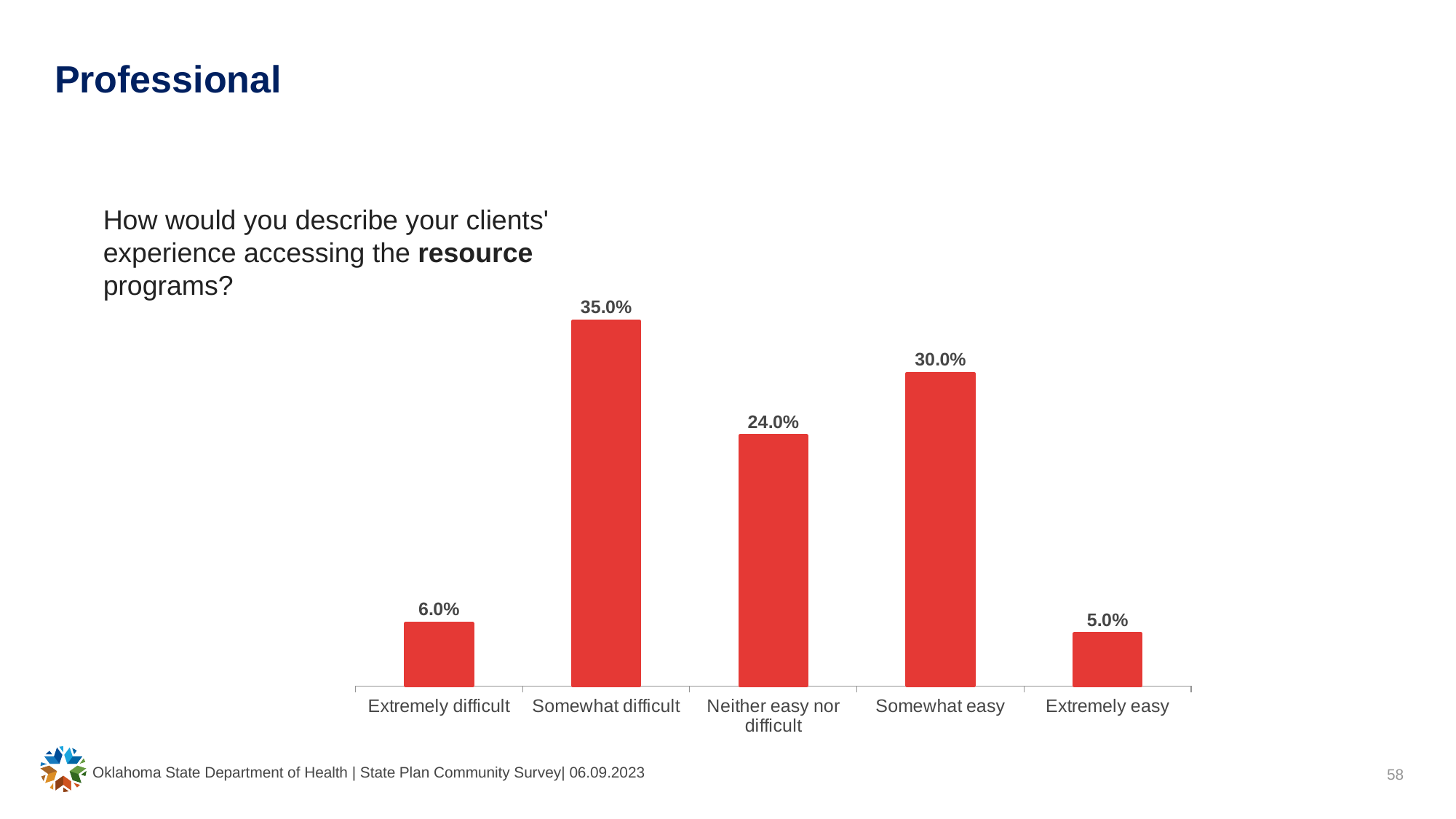
What is the difference between the values for 'Extremely difficult' and 'Extremely easy'? 1.0% What is the value shown for 'Neither easy nor difficult'? 24.0% What colour are the bars in the chart? Red Which is larger, the value for 'Somewhat easy' or the value for 'Neither easy nor difficult'? Somewhat easy How many categories are shown on the x axis of the chart? 5 What survey question does the chart present responses to? How would you describe your clients' experience accessing the resource programs? What kind of chart is shown on the slide? Bar chart What percentage of respondents said their clients' experience accessing the resource programs was 'Somewhat difficult'? 35.0% What is the difference between the values for 'Somewhat difficult' and 'Somewhat easy'? 5.0% Which category has the highest value in the chart? Somewhat difficult Which category has the lowest value in the chart? Extremely easy What is the value shown for 'Extremely easy'? 5.0%